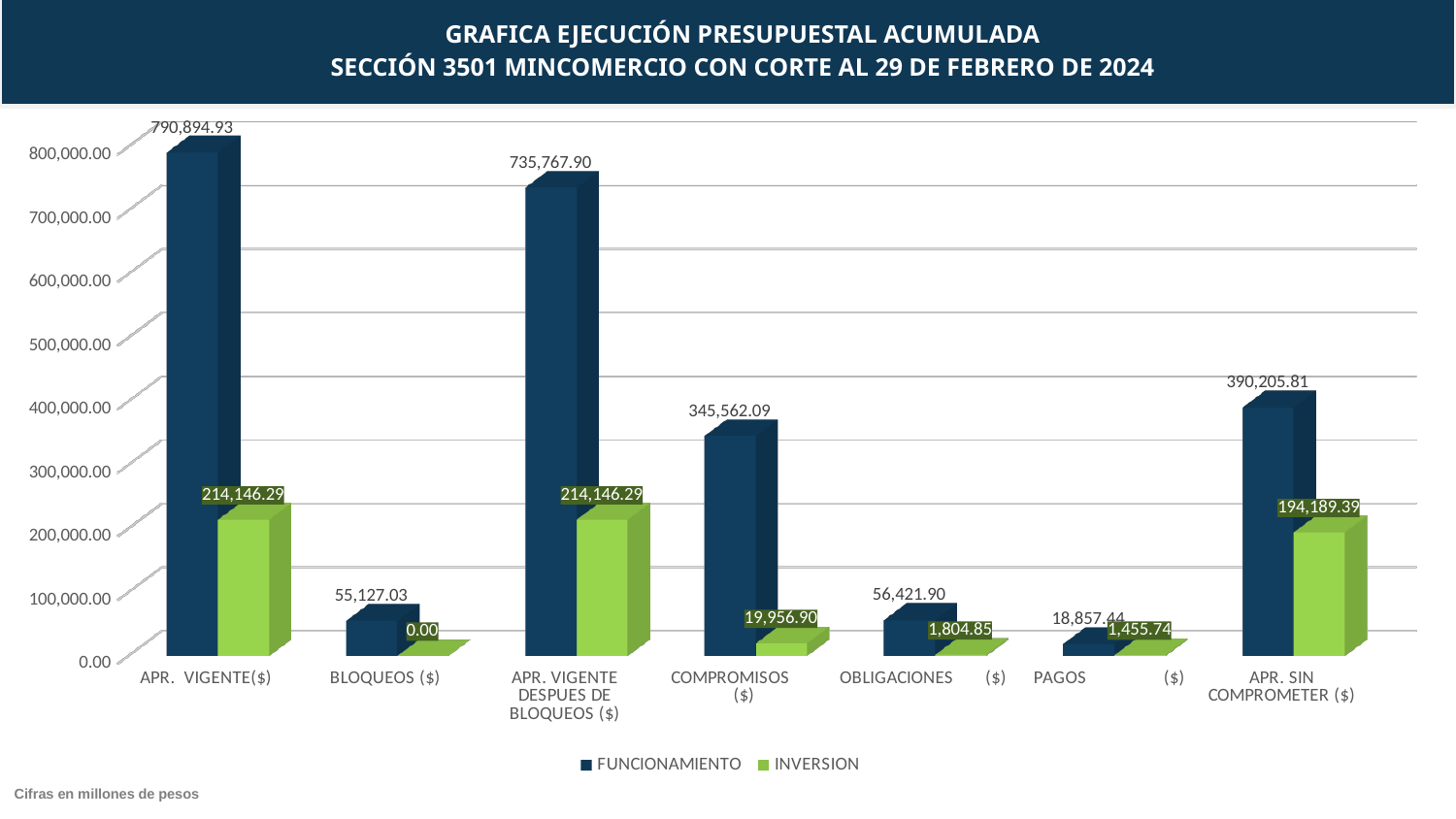
Is the FUNCIONAMIENTO value for APR. SIN COMPROMETER ($) greater or less than 400,000.00? less Which is larger: the FUNCIONAMIENTO value for OBLIGACIONES ($) or the FUNCIONAMIENTO value for BLOQUEOS ($)? OBLIGACIONES ($) What kind of chart is shown on the slide? bar chart Which category has the lowest INVERSION value? BLOQUEOS ($) Which category has the highest FUNCIONAMIENTO value? APR. VIGENTE($) What is the difference between the FUNCIONAMIENTO values for APR. VIGENTE($) and APR. VIGENTE DESPUES DE BLOQUEOS ($)? 55,127.03 What is the INVERSION value for COMPROMISOS ($)? 19,956.90 What is the FUNCIONAMIENTO value for PAGOS ($)? 18,857.44 What is the INVERSION value for BLOQUEOS ($)? 0.00 How many series does the legend list? 2 What is the FUNCIONAMIENTO value for APR. VIGENTE($)? 790,894.93 How many categories are shown on the x axis? 7